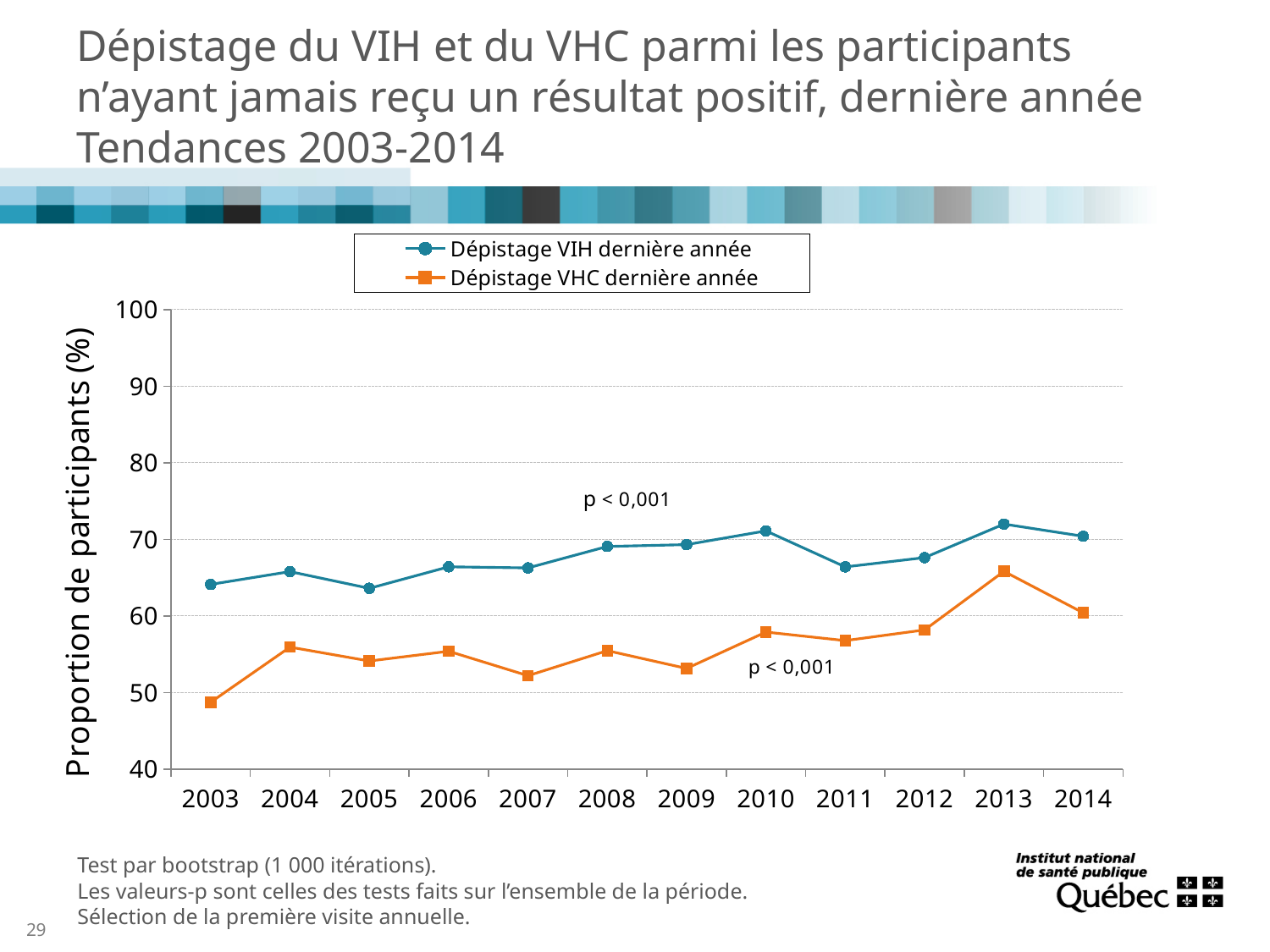
What kind of chart is shown on the slide? line chart Is the value for Dépistage VIH dernière année in 2005 greater or less than 60? greater Is the value for Dépistage VIH dernière année in 2010 greater or less than 70? greater How many years are plotted along the x axis? 12 Is the value for Dépistage VHC dernière année in 2003 greater or less than 50? less In which year is the value for Dépistage VHC dernière année the lowest? 2003 Does the value for Dépistage VHC dernière année rise or fall overall from 2003 to 2014? rise In which year is the value for Dépistage VHC dernière année the highest? 2013 What is the label of the y axis? Proportion de participants (%) In 2014, which series has the larger value: Dépistage VIH dernière année or Dépistage VHC dernière année? Dépistage VIH dernière année How many series does the legend list? 2